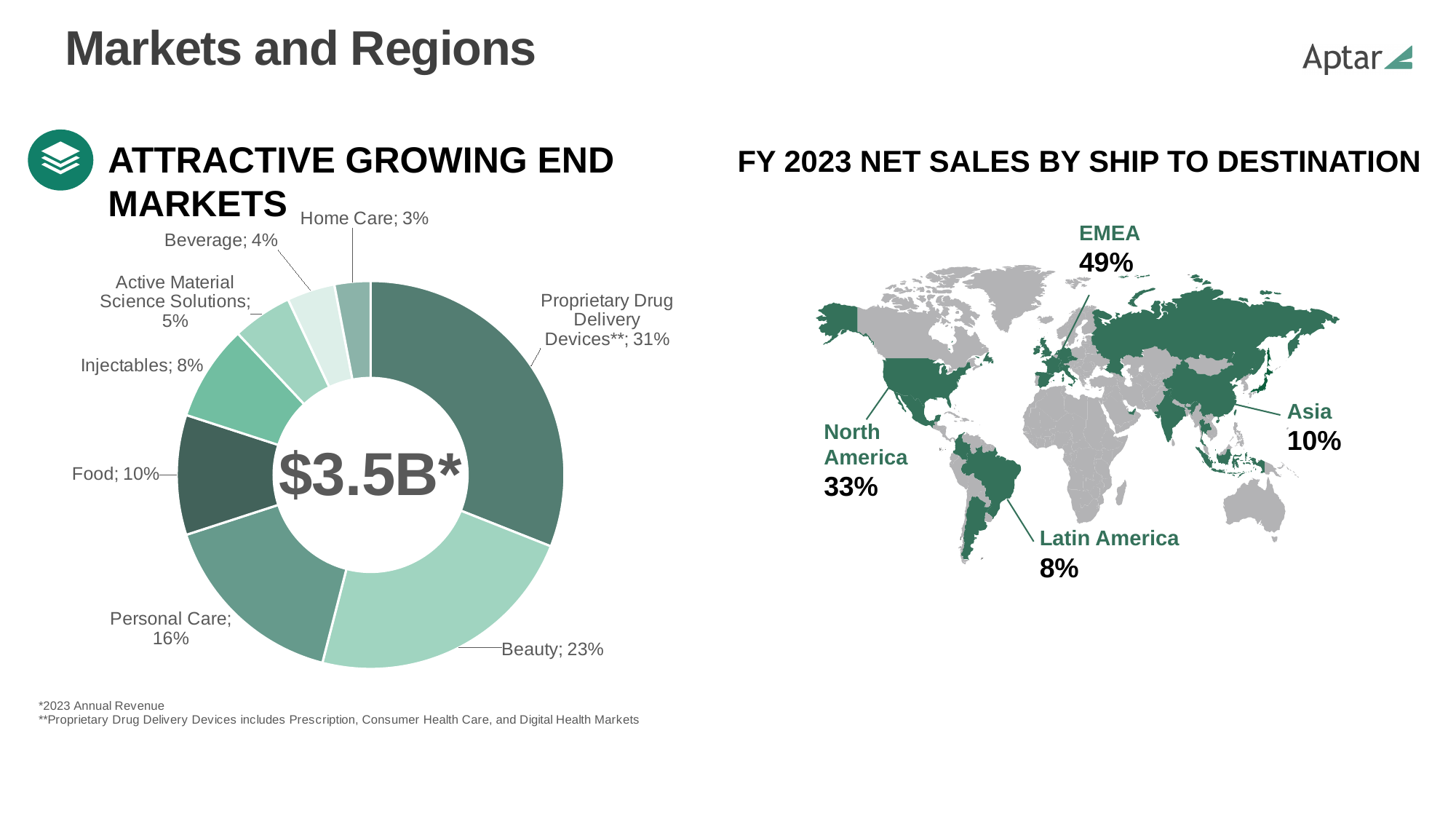
In the 'Attractive Growing End Markets' donut chart, what is the difference in percentage points between Beauty and Food? 13 In the 'Attractive Growing End Markets' donut chart, what share is Beauty? 23% In the 'FY 2023 Net Sales by Ship to Destination' map, what share of net sales is EMEA? 49% In the 'Attractive Growing End Markets' donut chart, which end market has the smallest share? Home Care In the 'Attractive Growing End Markets' donut chart, what share is Personal Care? 16% What total revenue figure is shown in the center of the 'Attractive Growing End Markets' donut chart? $3.5B* In the 'Attractive Growing End Markets' donut chart, which end market has the largest share? Proprietary Drug Delivery Devices How many end-market segments are shown in the 'Attractive Growing End Markets' donut chart? 8 In the 'Attractive Growing End Markets' donut chart, what share is Proprietary Drug Delivery Devices? 31% What kind of chart is used for 'Attractive Growing End Markets'? Donut (pie) chart In the 'FY 2023 Net Sales by Ship to Destination' map, what is the difference in percentage points between North America and Latin America? 25 In the 'Attractive Growing End Markets' donut chart, which is larger, Injectables or Active Material Science Solutions? Injectables